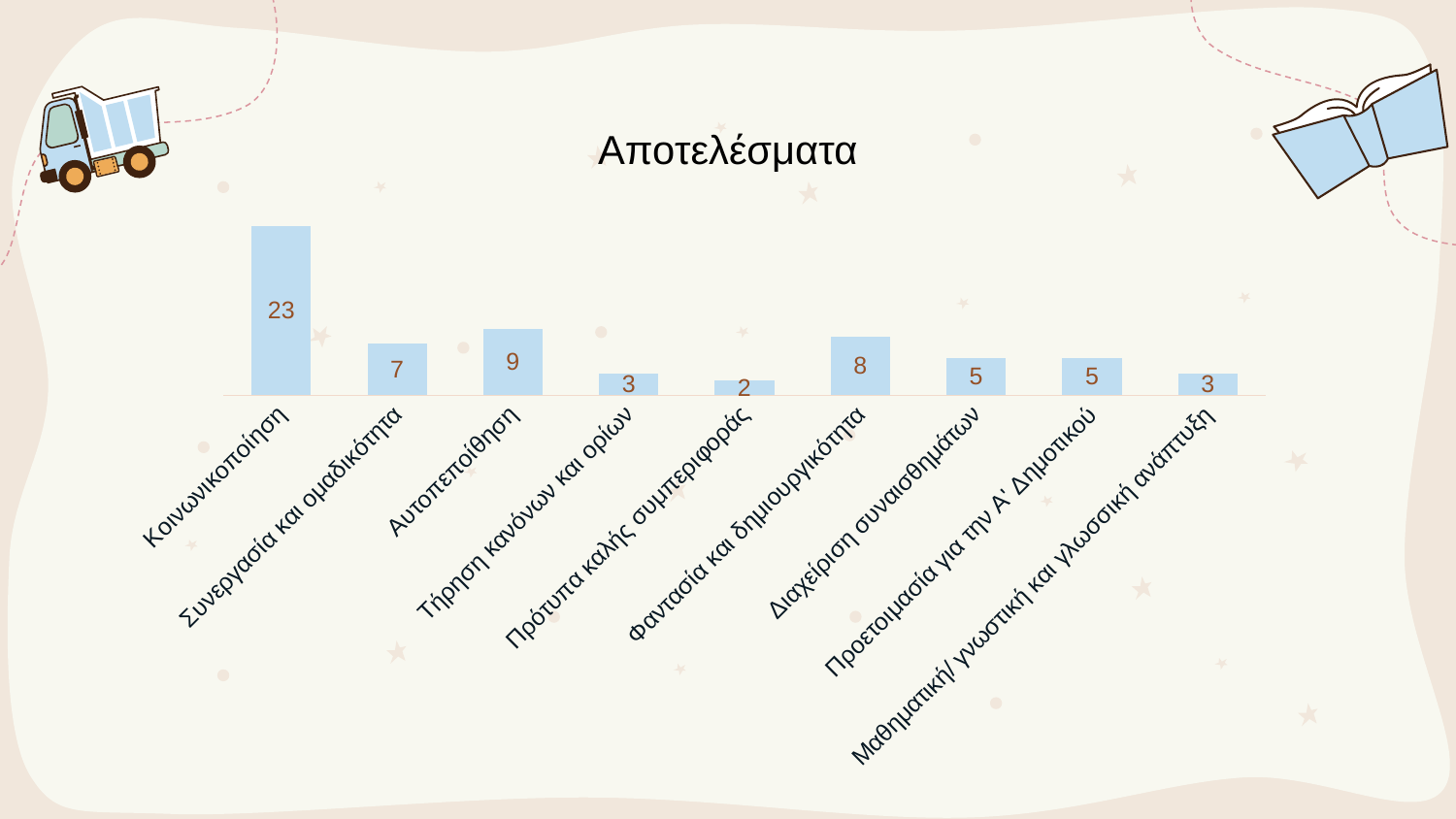
What is the value for Πρότυπα καλής συμπεριφοράς? 2 Which category has the highest value? Κοινωνικοποίηση Which category has the lowest value? Πρότυπα καλής συμπεριφοράς What is the difference between the values for Κοινωνικοποίηση and Αυτοπεποίθηση? 14 How many categories are shown in the chart? 9 Which is larger, the value for Συνεργασία και ομαδικότητα or the value for Αυτοπεποίθηση? Αυτοπεποίθηση What is the value for Αυτοπεποίθηση? 9 What is the value for Φαντασία και δημιουργικότητα? 8 What is the difference between the values for Φαντασία και δημιουργικότητα and Διαχείριση συναισθημάτων? 3 What is the title of the chart? Αποτελέσματα What is the value for Κοινωνικοποίηση? 23 What kind of chart is shown on the slide? Bar chart